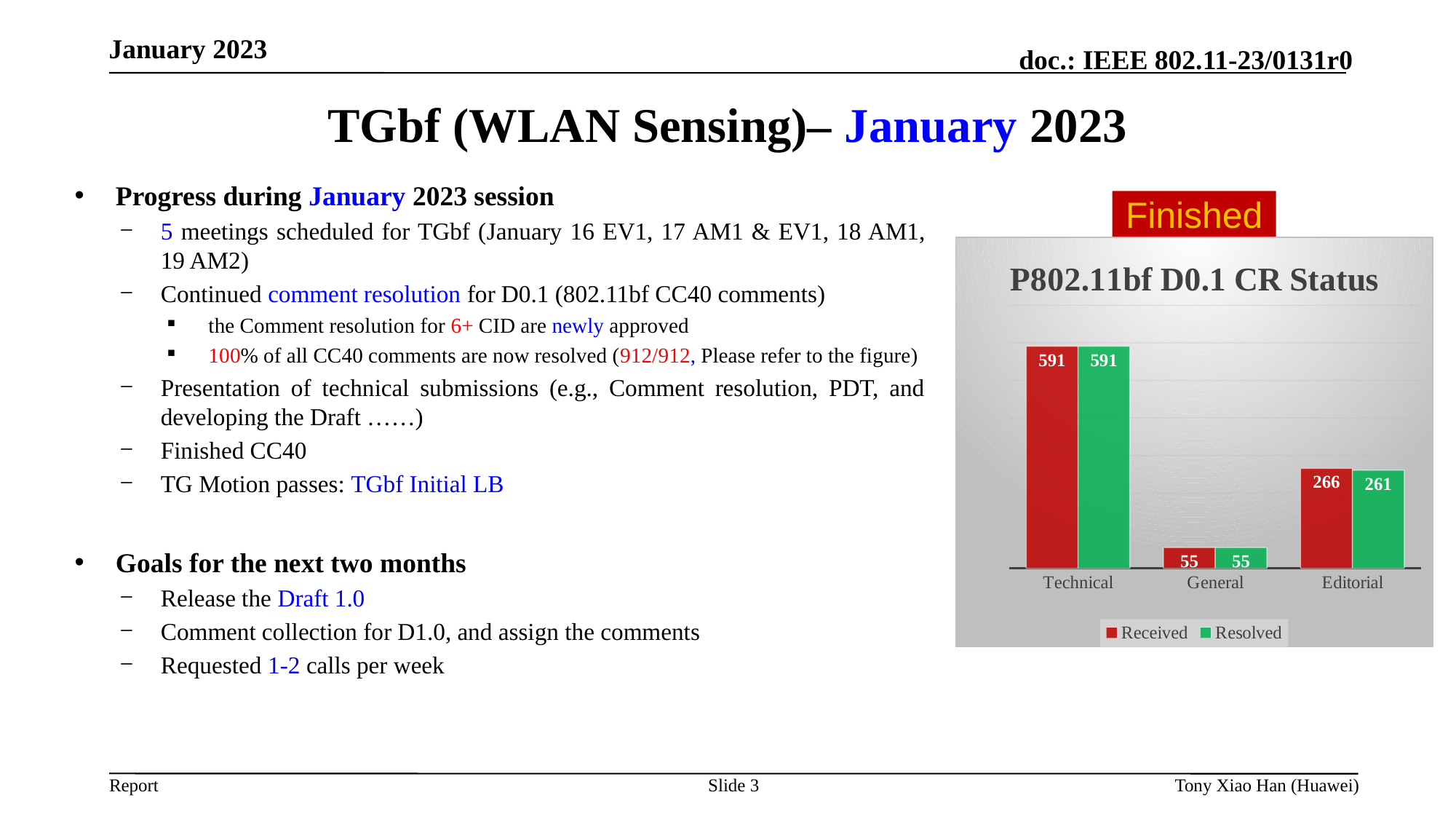
Which category has the lowest Resolved value? General What is the difference between the Received and Resolved values for Editorial? 5 What is the Resolved value for Editorial? 261 What kind of chart is shown? bar chart Which category has the highest Received value? Technical What is the title of the chart? P802.11bf D0.1 CR Status How many series does the legend list? 2 What is the Received value for Technical? 591 What is the Received value for General? 55 Which is larger, the Received value for Editorial or the Received value for General? Editorial What is the difference between the Received values for Technical and Editorial? 325 How many categories are shown on the x axis? 3